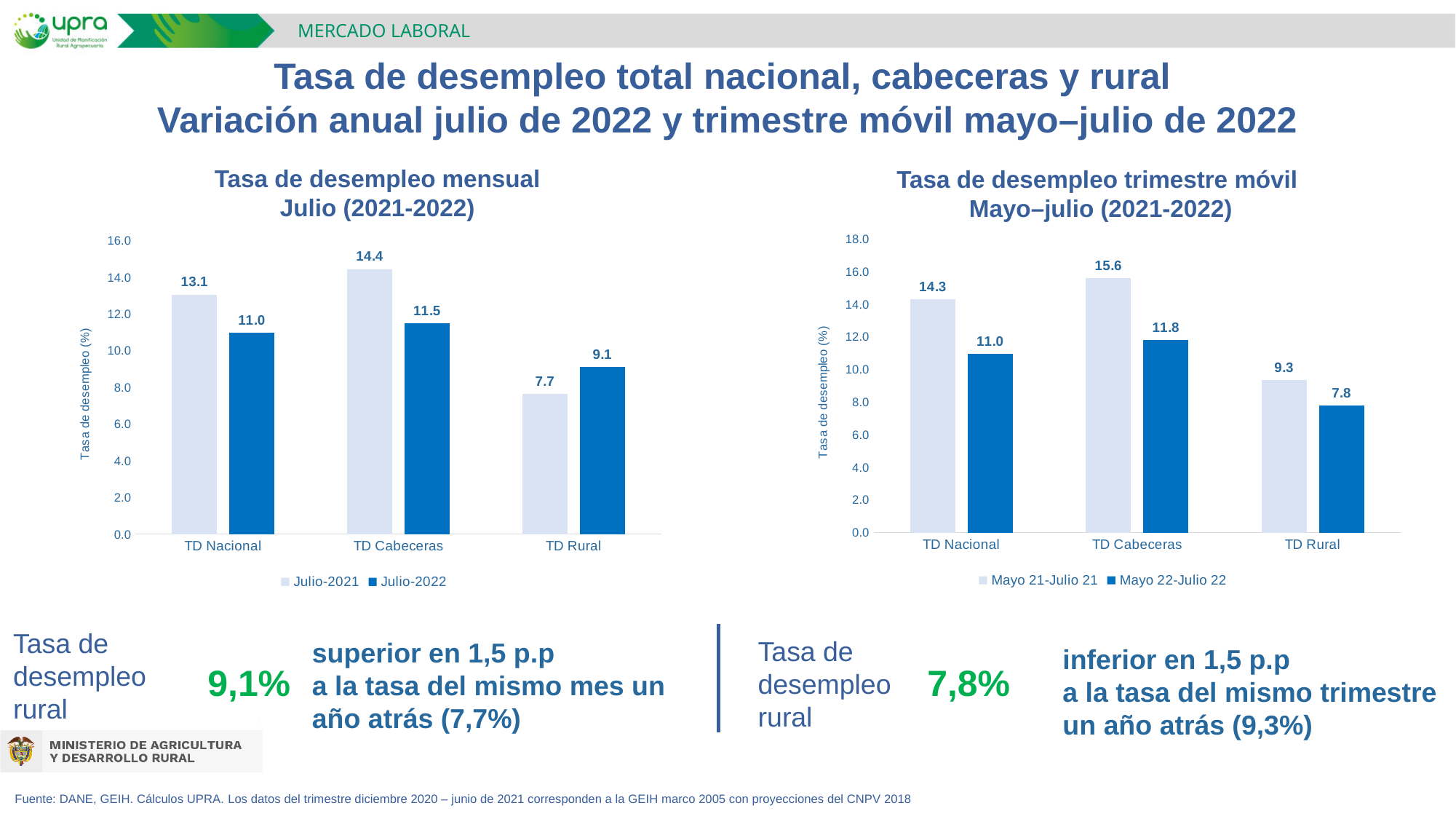
In the right chart (Tasa de desempleo trimestre móvil), which category has the lowest Mayo 22-Julio 22 value? TD Rural In the right chart (Tasa de desempleo trimestre móvil), what is the value for TD Cabeceras in Mayo 22-Julio 22? 11.8 In the left chart (Tasa de desempleo mensual Julio), which is larger for TD Rural: the Julio-2021 value or the Julio-2022 value? Julio-2022 How many series does the legend of the left chart (Tasa de desempleo mensual Julio) list? 2 In the right chart (Tasa de desempleo trimestre móvil), what is the value for TD Rural in Mayo 21-Julio 21? 9.3 In the left chart (Tasa de desempleo mensual Julio), what is the value for TD Nacional in Julio-2022? 11.0 How many categories are shown on the x axis of the right chart (Tasa de desempleo trimestre móvil)? 3 In the left chart (Tasa de desempleo mensual Julio), what is the value for TD Rural in Julio-2021? 7.7 In the left chart (Tasa de desempleo mensual Julio), what is the difference between the Julio-2021 and Julio-2022 values for TD Cabeceras? 2.9 In the left chart (Tasa de desempleo mensual Julio), which category has the highest Julio-2021 value? TD Cabeceras In the right chart (Tasa de desempleo trimestre móvil), what is the difference between the Mayo 21-Julio 21 and Mayo 22-Julio 22 values for TD Nacional? 3.3 What kind of chart is the right chart (Tasa de desempleo trimestre móvil)? Bar chart